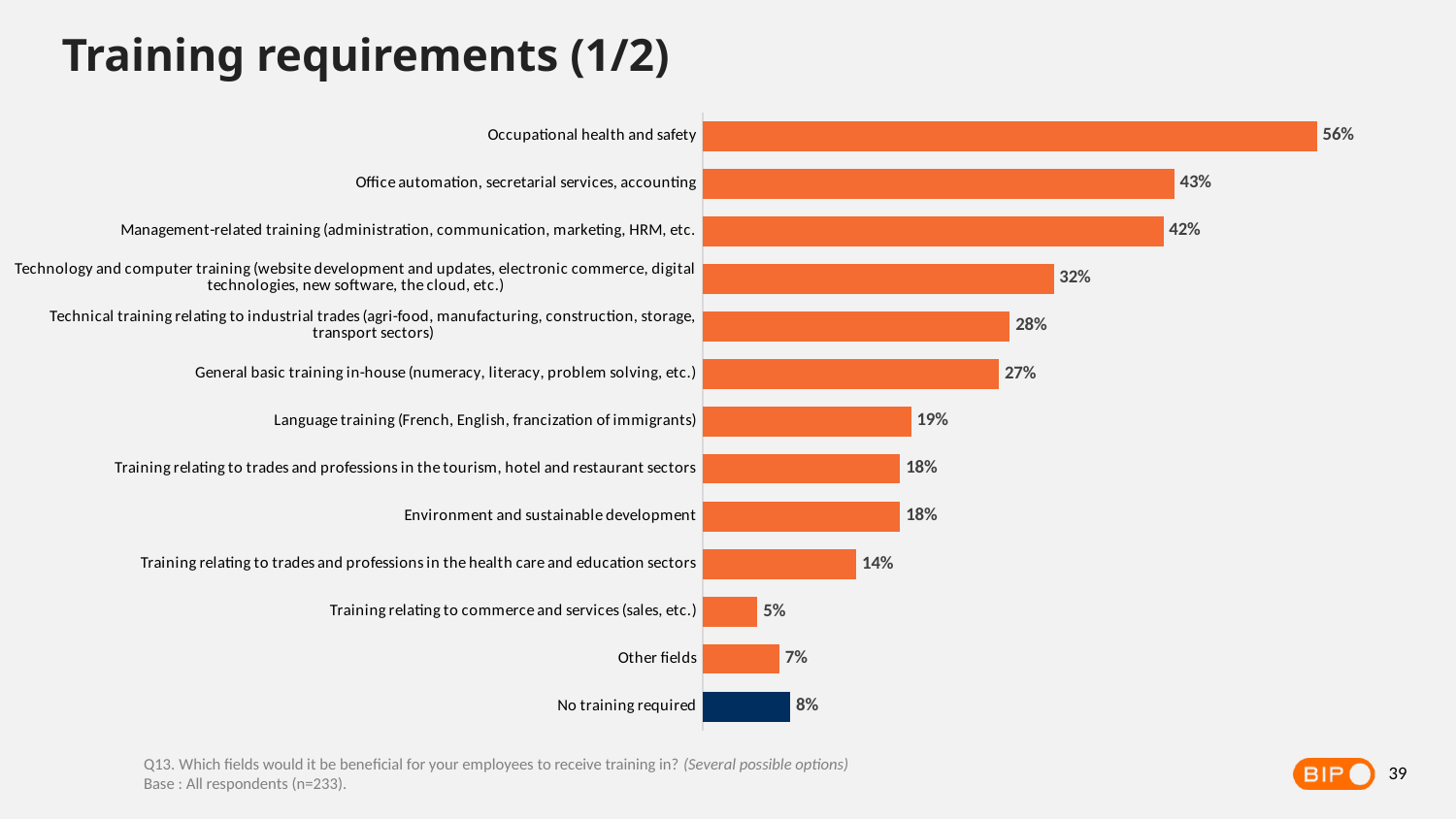
Which is larger: Other fields or Training relating to commerce and services? Other fields Which category has the lowest percentage on the chart? Training relating to commerce and services (sales, etc.) What is the difference between Occupational health and safety and Technology and computer training? 24 percentage points Which bar is shown in a different colour (dark blue) from the others? No training required What percentage is shown for No training required? 8% What percentage of respondents selected Occupational health and safety as a training requirement? 56% What is the difference in percentage points between Office automation, secretarial services, accounting and Management-related training? 1 percentage point What is the value shown for Environment and sustainable development? 18% What type of chart is shown on the slide? Bar chart How many categories are shown on the chart? 13 Which is larger: Language training or Training relating to trades and professions in the health care and education sectors? Language training Which training field has the highest percentage? Occupational health and safety